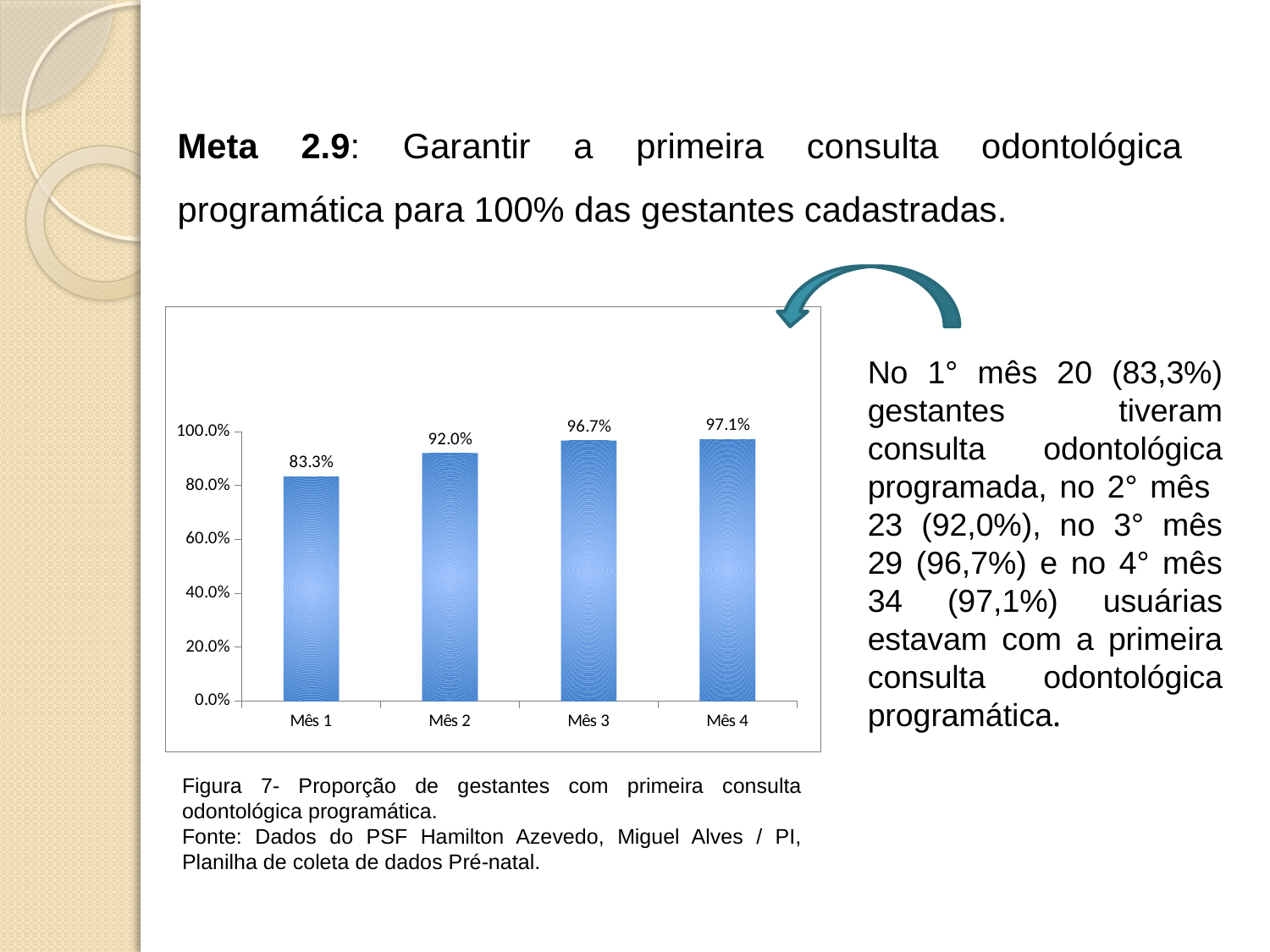
Which month has the highest value? Mês 4 How many months are shown on the x axis? 4 What is the value for Mês 3? 96.7% What is the value for Mês 4? 97.1% Is the value for Mês 1 greater or less than 80.0%? greater What is the highest tick value shown on the y axis? 100.0% Which month has the lowest value? Mês 1 What kind of chart is shown? bar chart What is the value for Mês 1? 83.3% Do the values rise or fall from Mês 1 to Mês 4? rise Which is larger, the value for Mês 2 or the value for Mês 3? Mês 3 What is the difference between the values for Mês 2 and Mês 1? 8.7%